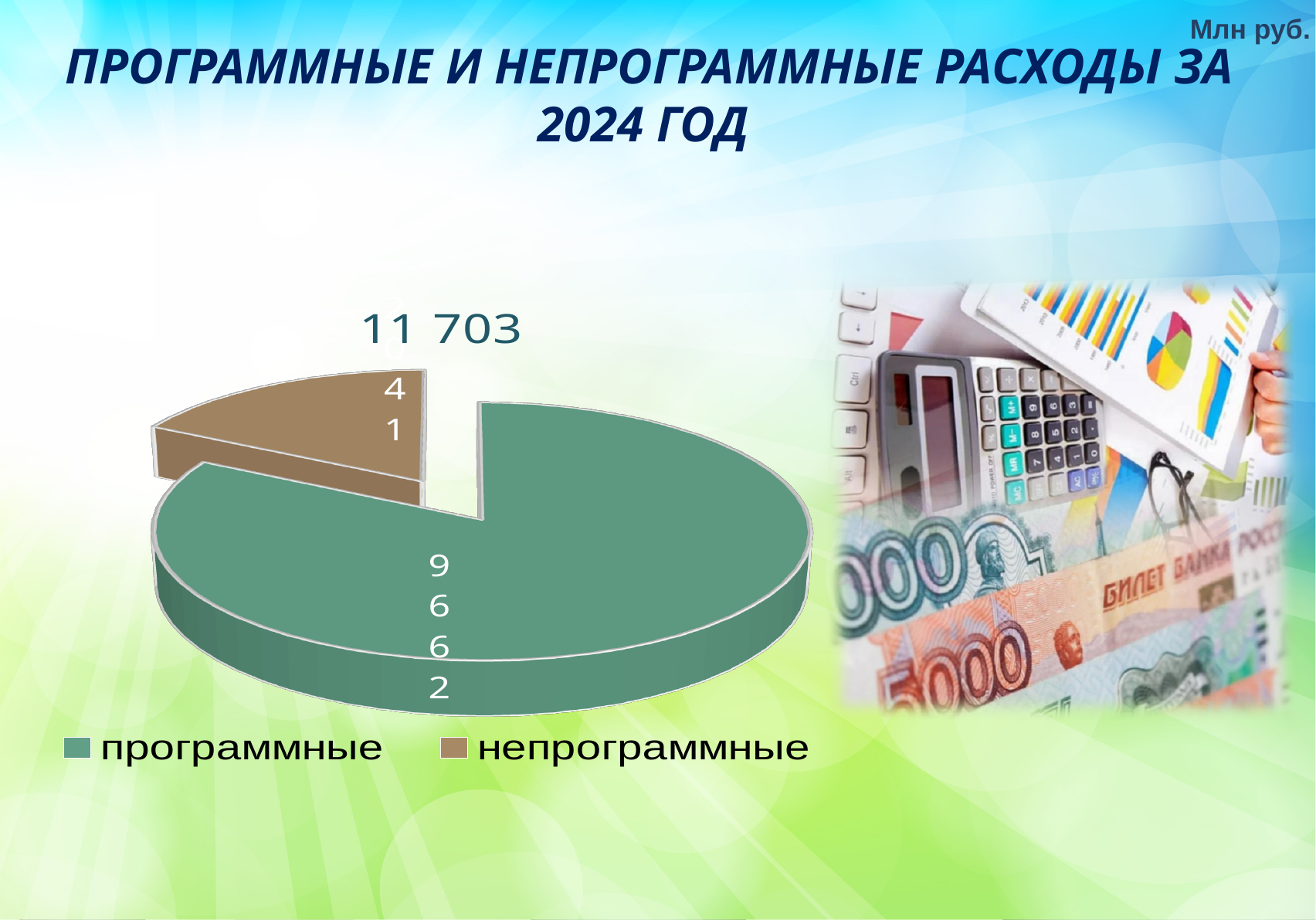
Which slice is larger, программные or непрограммные? программные What kind of chart is shown on the slide? pie chart What is the title of the chart on the slide? ПРОГРАММНЫЕ И НЕПРОГРАММНЫЕ РАСХОДЫ ЗА 2024 ГОД What unit is indicated in the top right corner of the slide? Млн руб. Which category has the smallest slice of the pie chart? непрограммные Does the программные slice account for more or less than half of the pie? more than half How many entries does the legend of the pie chart list? 2 How many slices does the pie chart have? 2 Which category has the largest slice of the pie chart? программные